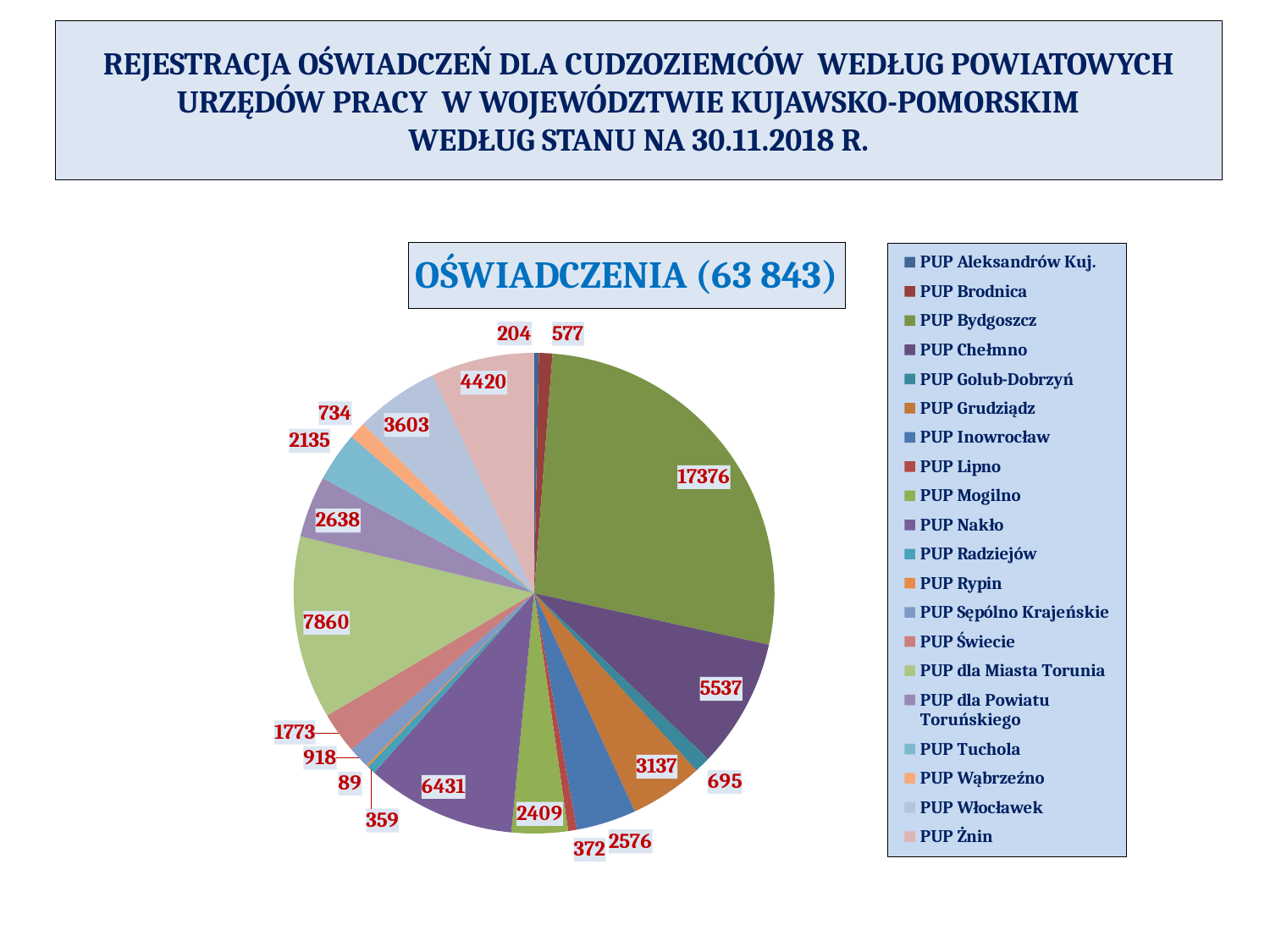
What is the value for PUP Rypin? 89 What is the value for PUP Bydgoszcz? 17376 Which PUP has the largest slice of the pie? PUP Bydgoszcz What total is given in the chart title? 63 843 What type of chart is shown on the slide? pie chart How many PUP categories are shown in the pie chart? 20 What is the difference between the values for PUP Bydgoszcz and PUP dla Miasta Torunia? 9516 Which is larger, the value for PUP Nakło or PUP Chełmno? PUP Nakło What is the difference between the values for PUP Żnin and PUP Włocławek? 817 What is the value for PUP Włocławek? 3603 Which PUP has the smallest slice of the pie? PUP Rypin What is the value for PUP dla Miasta Torunia? 7860